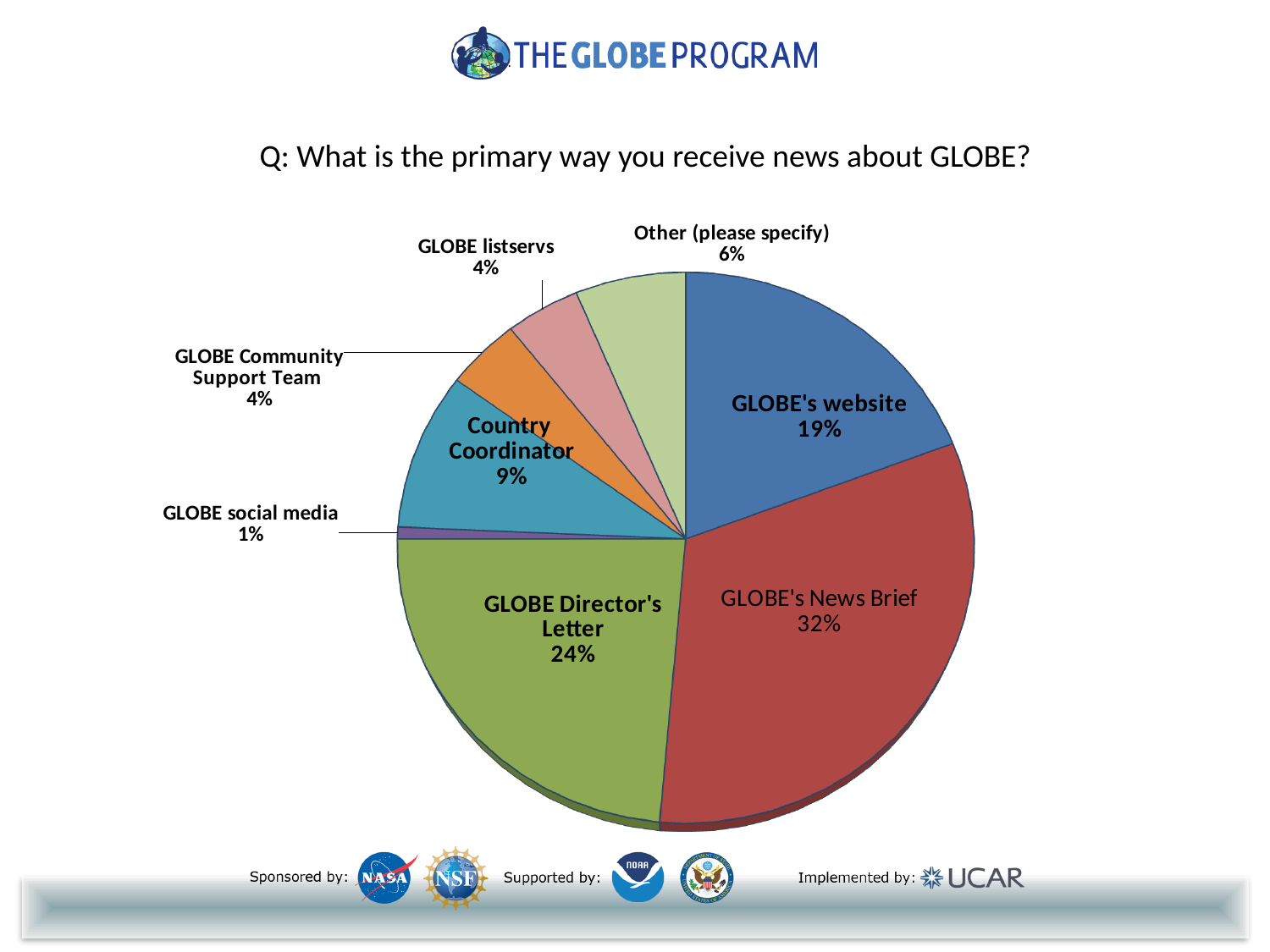
What percentage is shown for Country Coordinator? 9% How many categories are shown in the pie chart? 8 What percentage of respondents receive news about GLOBE primarily through GLOBE's News Brief? 32% Which category has the smallest slice of the pie? GLOBE social media What kind of chart is shown on the slide? Pie chart What percentage is shown for Other (please specify)? 6% What is the value shown for GLOBE's website? 19% Which is larger, the share for GLOBE's website or the share for Country Coordinator? GLOBE's website What question is the chart answering, according to the title above it? What is the primary way you receive news about GLOBE? What share of the pie is labelled GLOBE Director's Letter? 24% What is the difference in percentage points between GLOBE's News Brief and GLOBE Director's Letter? 8 Which category has the largest slice of the pie? GLOBE's News Brief